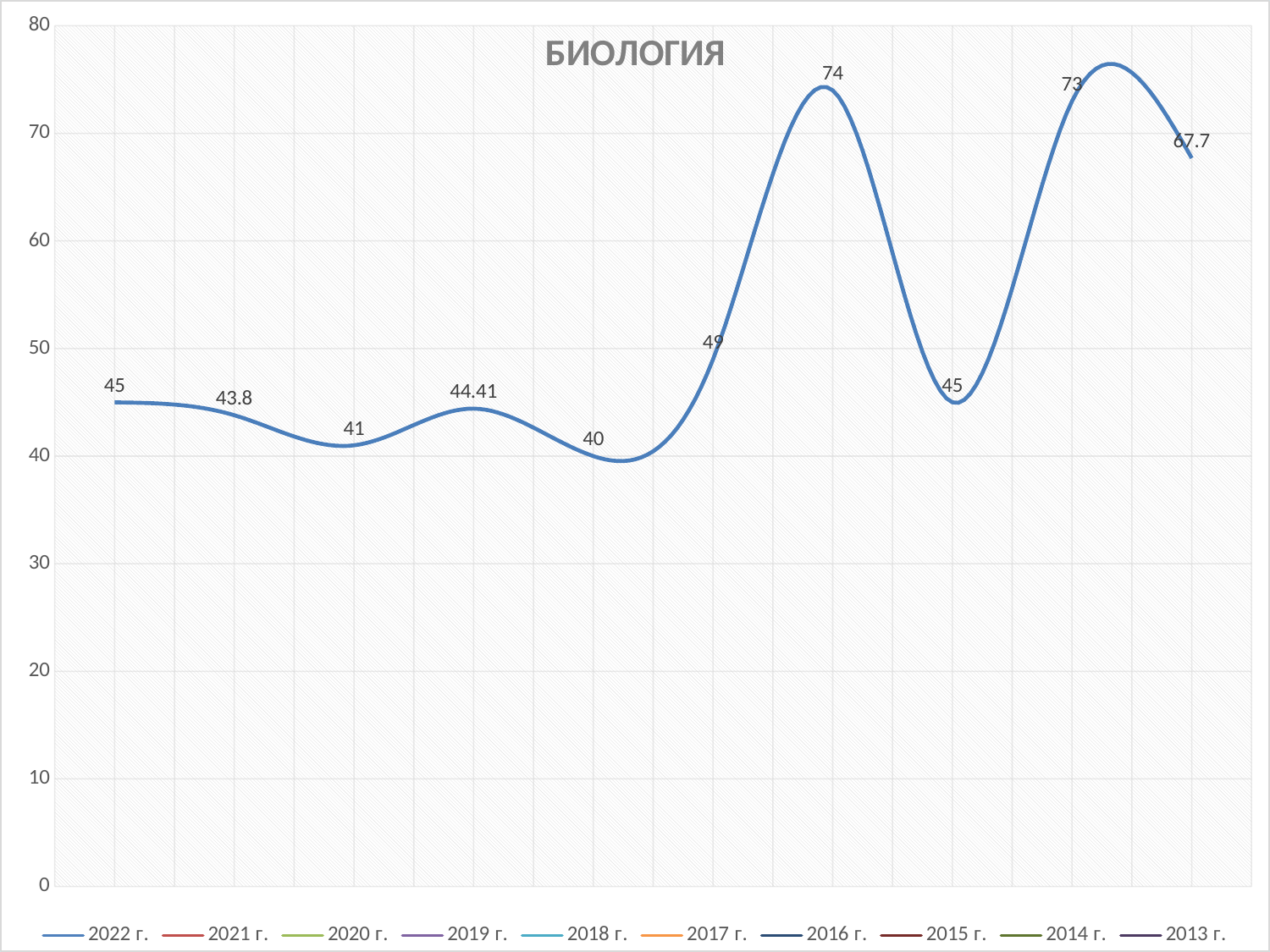
What is the difference between the highest labelled value (74) and the lowest labelled value (40)? 34 What is the title of the chart? БИОЛОГИЯ What is the value of the leftmost point on the line? 45 Is the highest point on the line greater or less than 70? greater What is the lowest labelled value on the line? 40 What kind of chart is shown on the slide? line chart How many entries does the chart legend list? 10 What is the highest labelled value on the line? 74 What is the value of the rightmost point on the line? 67.7 Which is larger, the value of the second-to-last point (73) or the last point (67.7)? 73 How many data points are labelled on the plotted line? 10 What is the value of the fourth point from the left on the line? 44.41